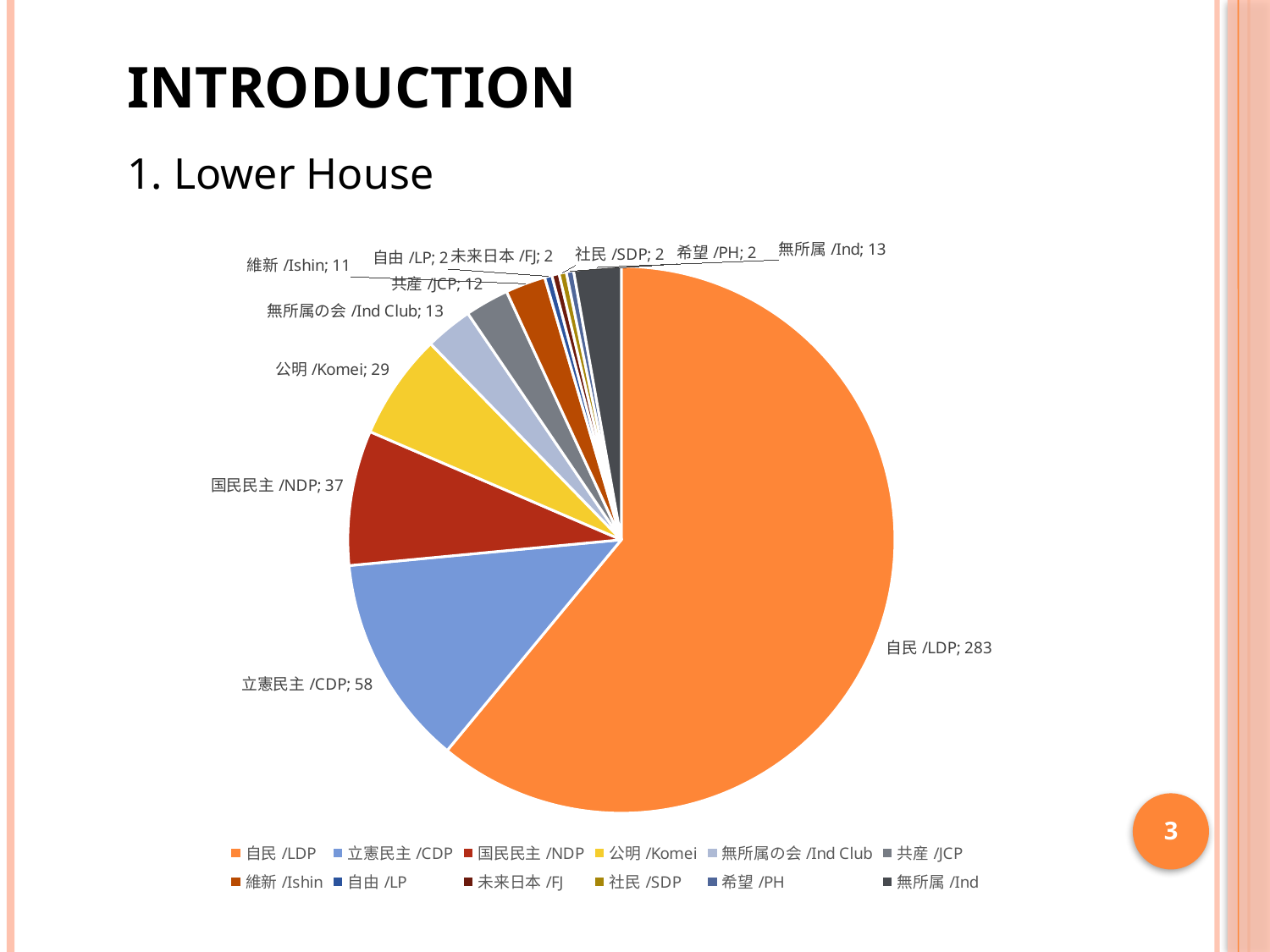
Which party has the largest slice of the pie chart? 自民 /LDP What is the difference between the values for 立憲民主 /CDP and 国民民主 /NDP? 21 What is the value shown for 無所属 /Ind? 13 Which is larger, the value for 公明 /Komei or the value for 維新 /Ishin? 公明 /Komei How many categories does the legend of the pie chart list? 12 How many seats does 自民 /LDP have in the pie chart? 283 What is the difference between the values for 自民 /LDP and 立憲民主 /CDP? 225 What is the value shown for 共産 /JCP? 12 What is the value shown for 立憲民主 /CDP? 58 What colour is the slice for 自民 /LDP? orange What is the value shown for 公明 /Komei? 29 What kind of chart is shown on the slide? pie chart